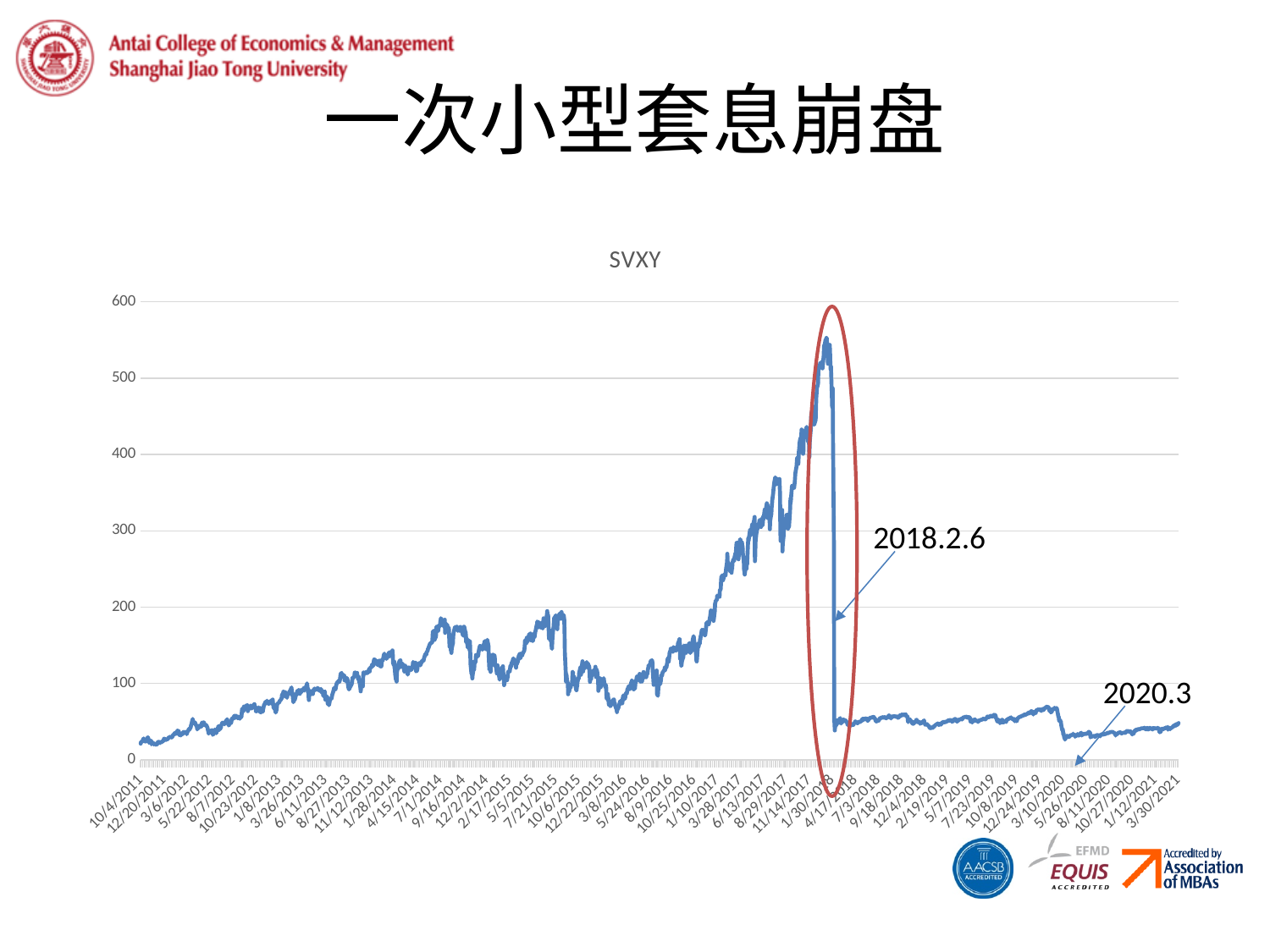
Is the value of SVXY at the start of the series (10/4/2011) greater or less than 100? less After the 2018.2.6 drop, does SVXY ever rise above 100 again through 3/30/2021? No What kind of chart is shown on the slide? line chart Which two dates are annotated on the chart? 2018.2.6 and 2020.3 Is the peak value of SVXY just before the circled drop in early 2018 greater or less than 500? greater Which is larger: the value of SVXY at its early-2018 peak or its value at 3/30/2021? the early-2018 peak Does the SVXY series generally rise or fall from 10/4/2011 to its peak in early 2018? rise What is the title of the chart? SVXY Which is larger: the value of SVXY around 7/1/2014 or its value at 3/30/2021? 7/1/2014